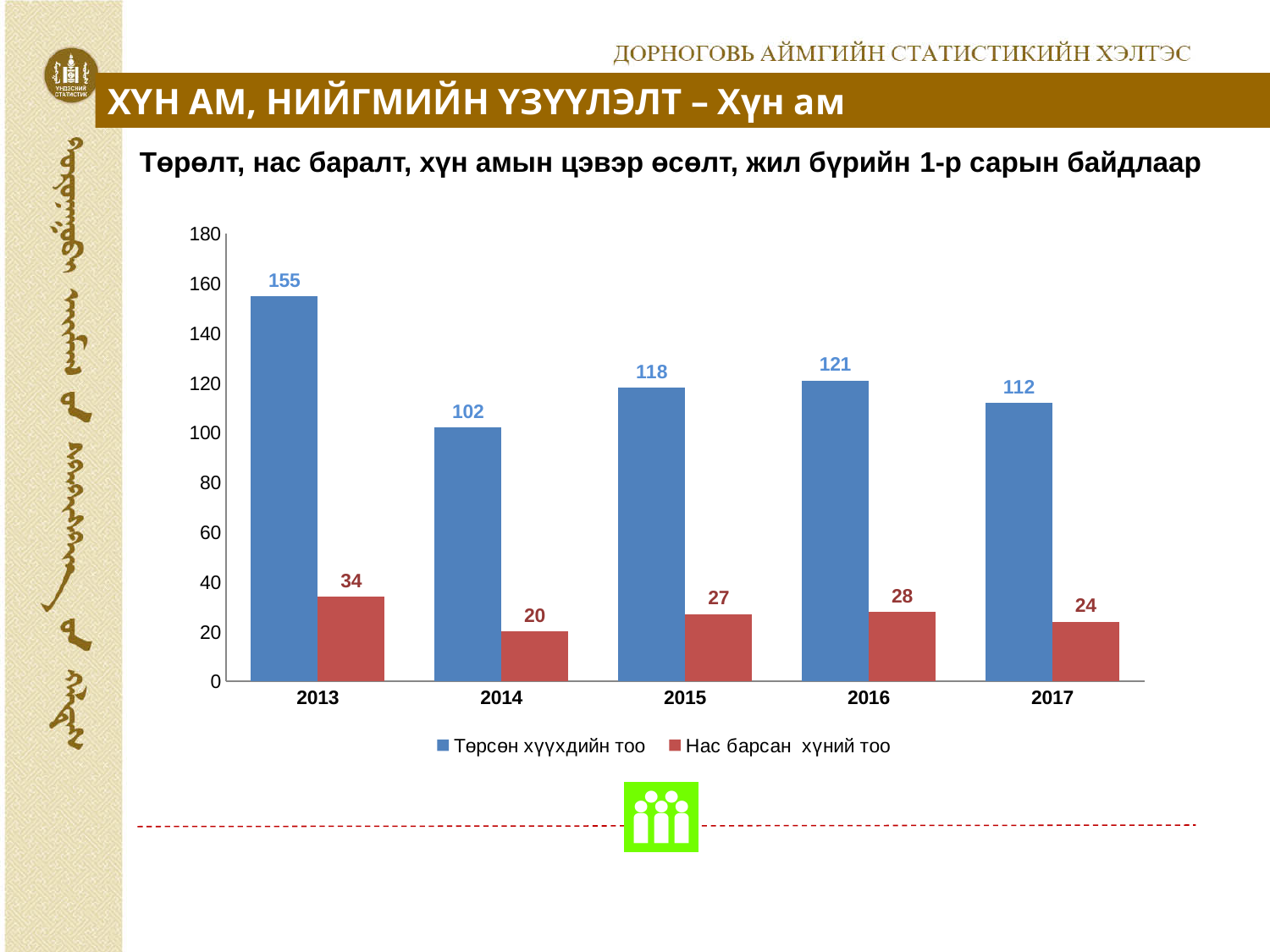
What kind of chart is shown on the slide? bar chart Is the value for Төрсөн хүүхдийн тоо in 2014 greater or less than 120? less How many series does the legend list? 2 What is the value for Төрсөн хүүхдийн тоо in 2017? 112 Which year has the highest value for Төрсөн хүүхдийн тоо? 2013 How many years are shown on the x axis? 5 Which is larger: Төрсөн хүүхдийн тоо in 2015 or in 2016? 2016 Which year has the lowest value for Нас барсан хүний тоо? 2014 What colour are the bars for Нас барсан хүний тоо? red What is the value for Төрсөн хүүхдийн тоо in 2013? 155 What is the value for Нас барсан хүний тоо in 2015? 27 What is the difference between Төрсөн хүүхдийн тоо and Нас барсан хүний тоо in 2016? 93